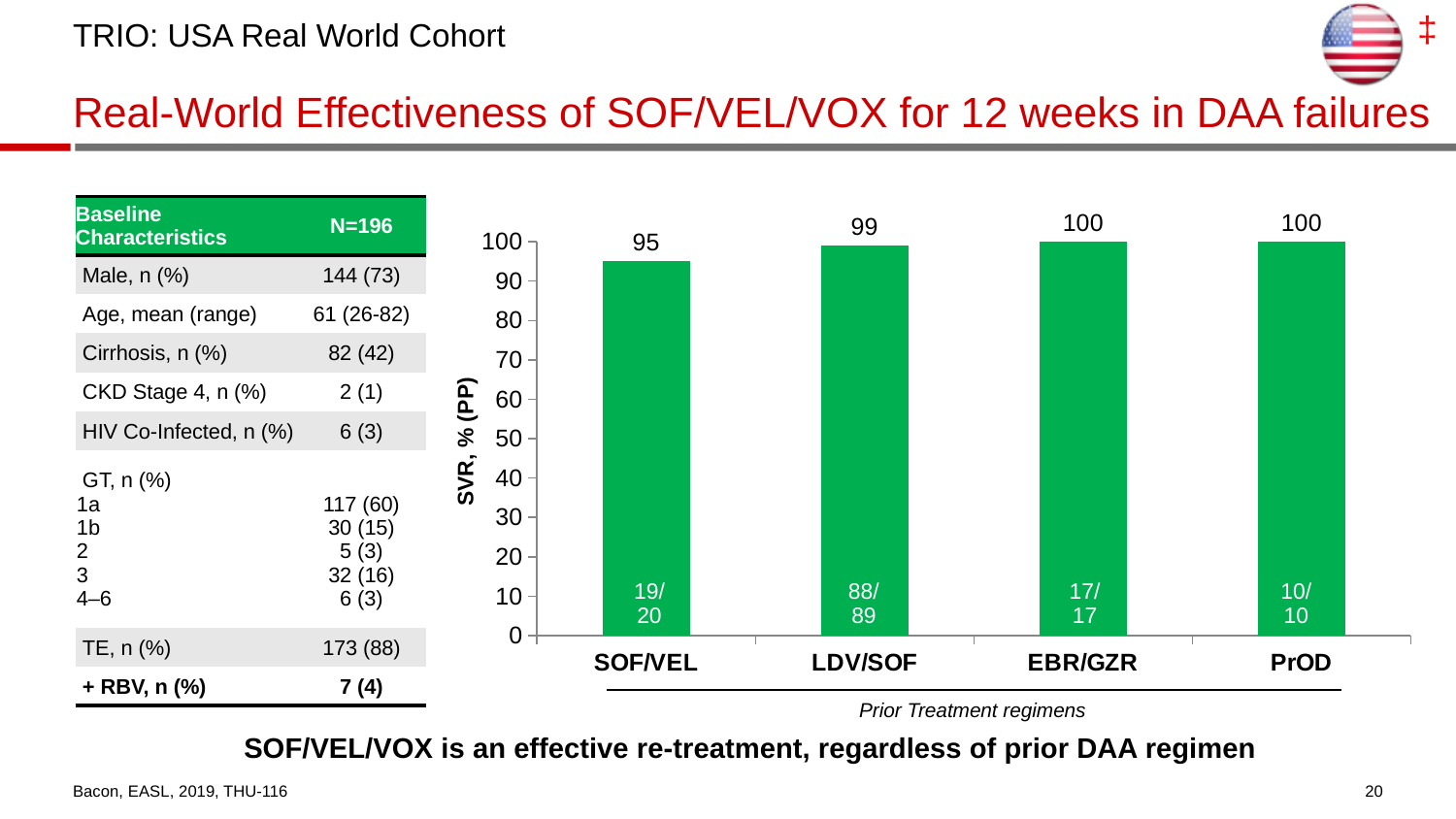
What is the label of the x axis of the chart? Prior Treatment regimens What is the label of the y axis of the chart? SVR, % (PP) How many prior treatment regimens are shown on the x axis of the chart? 4 What fraction (n/N) is printed inside the SOF/VEL bar? 19/20 What is the SVR, % (PP) value for SOF/VEL? 95 What is the SVR, % (PP) value for LDV/SOF? 99 What fraction (n/N) is printed inside the LDV/SOF bar? 88/89 What is the difference in SVR, % (PP) between LDV/SOF and SOF/VEL? 4 What kind of chart is shown on the slide? bar chart What is the SVR, % (PP) value for EBR/GZR? 100 Which has a higher SVR, % (PP): SOF/VEL or LDV/SOF? LDV/SOF Which prior treatment regimen has the lowest SVR, % (PP)? SOF/VEL